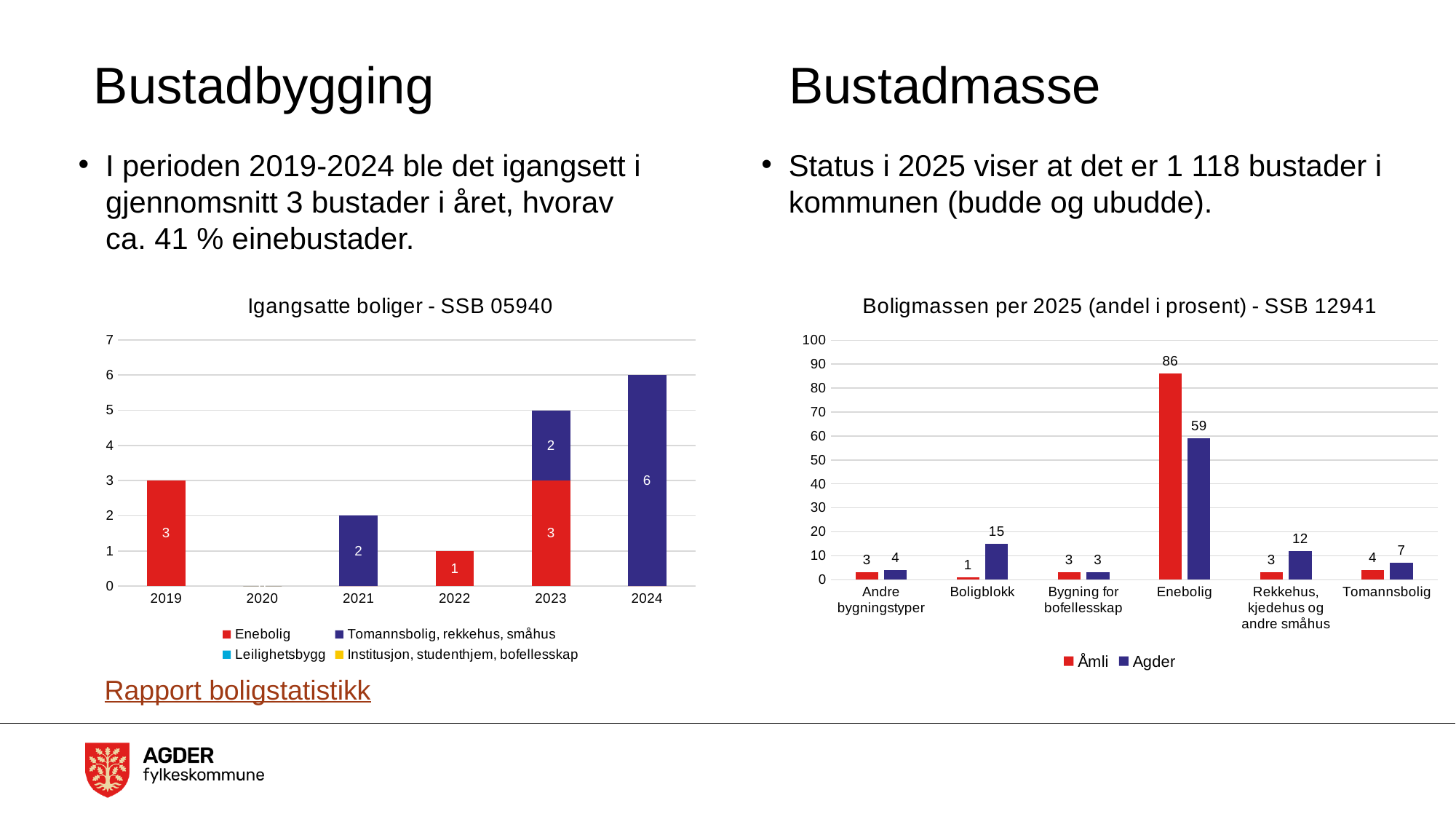
In the chart 'Igangsatte boliger - SSB 05940', what is the total of the stacked bar for 2023? 5 In the chart 'Igangsatte boliger - SSB 05940', what is the Enebolig value for 2019? 3 In the chart 'Igangsatte boliger - SSB 05940', what is the Tomannsbolig, rekkehus, småhus value for 2024? 6 In the chart 'Boligmassen per 2025 (andel i prosent) - SSB 12941', what is the Åmli value for Enebolig? 86 In the chart 'Boligmassen per 2025 (andel i prosent) - SSB 12941', how many categories are shown on the x axis? 6 In the chart 'Igangsatte boliger - SSB 05940', how many series does the legend list? 4 In the chart 'Igangsatte boliger - SSB 05940', how many years are shown on the x axis? 6 What kind of chart is 'Igangsatte boliger - SSB 05940'? Stacked bar chart In the chart 'Boligmassen per 2025 (andel i prosent) - SSB 12941', which category has the highest Agder value? Enebolig In the chart 'Boligmassen per 2025 (andel i prosent) - SSB 12941', which is larger for Rekkehus, kjedehus og andre småhus: Åmli or Agder? Agder In the chart 'Boligmassen per 2025 (andel i prosent) - SSB 12941', what is the Agder value for Boligblokk? 15 In the chart 'Boligmassen per 2025 (andel i prosent) - SSB 12941', what is the difference between the Åmli and Agder values for Enebolig? 27